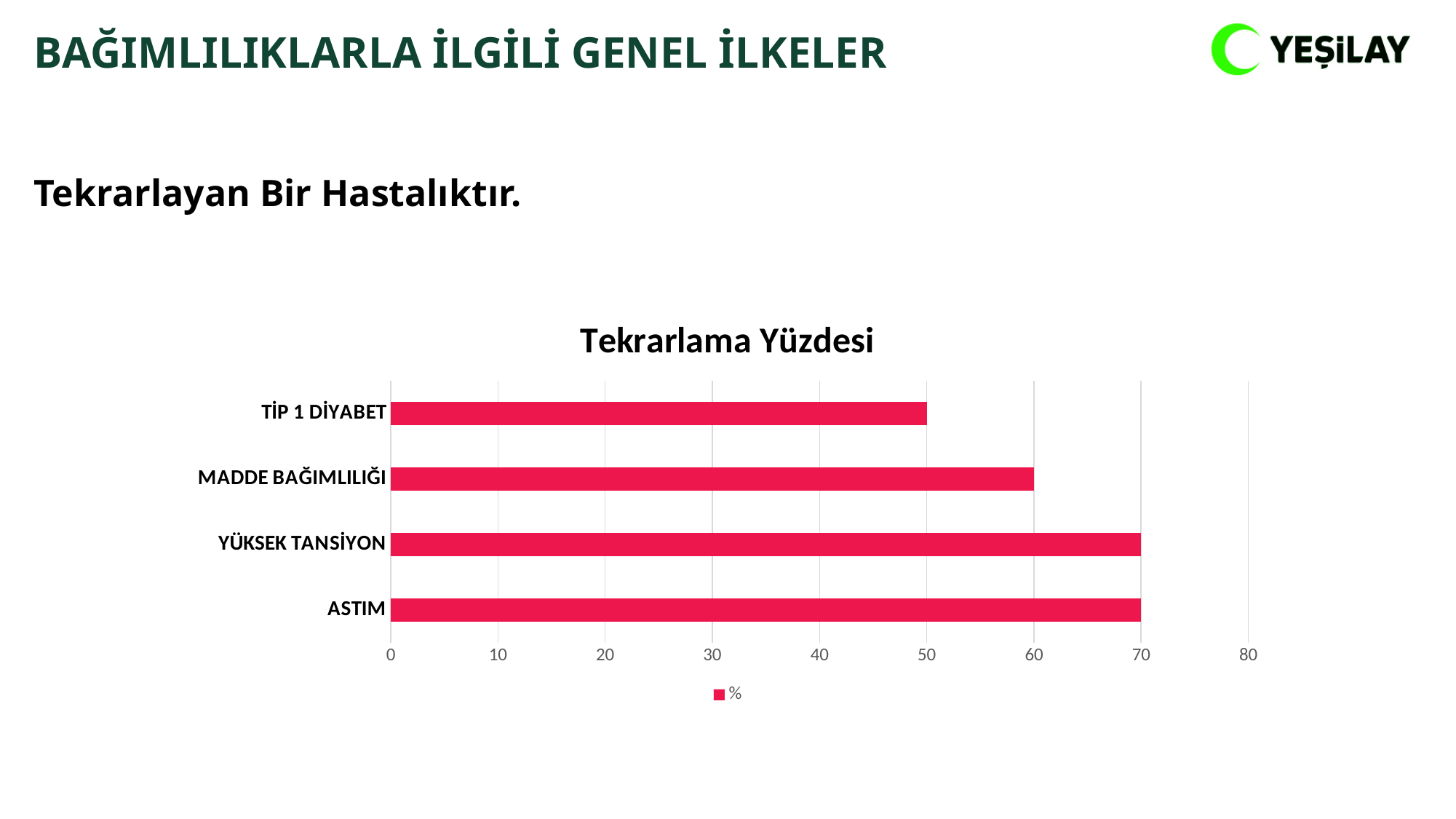
Is the value for MADDE BAĞIMLILIĞI greater or less than 50? greater What is the title of the chart on the slide? Tekrarlama Yüzdesi Which category has the lowest value in the Tekrarlama Yüzdesi chart? TİP 1 DİYABET What is the difference between the values for MADDE BAĞIMLILIĞI and TİP 1 DİYABET? 10 What is the value for MADDE BAĞIMLILIĞI in the Tekrarlama Yüzdesi chart? 60 What is the value for ASTIM in the Tekrarlama Yüzdesi chart? 70 How many categories are shown in the Tekrarlama Yüzdesi chart? 4 Which is larger, the value for MADDE BAĞIMLILIĞI or the value for TİP 1 DİYABET? MADDE BAĞIMLILIĞI What is the difference between the values for YÜKSEK TANSİYON and MADDE BAĞIMLILIĞI? 10 What is the value for TİP 1 DİYABET in the Tekrarlama Yüzdesi chart? 50 What is the value for YÜKSEK TANSİYON in the Tekrarlama Yüzdesi chart? 70 What kind of chart is shown on the slide? Bar chart